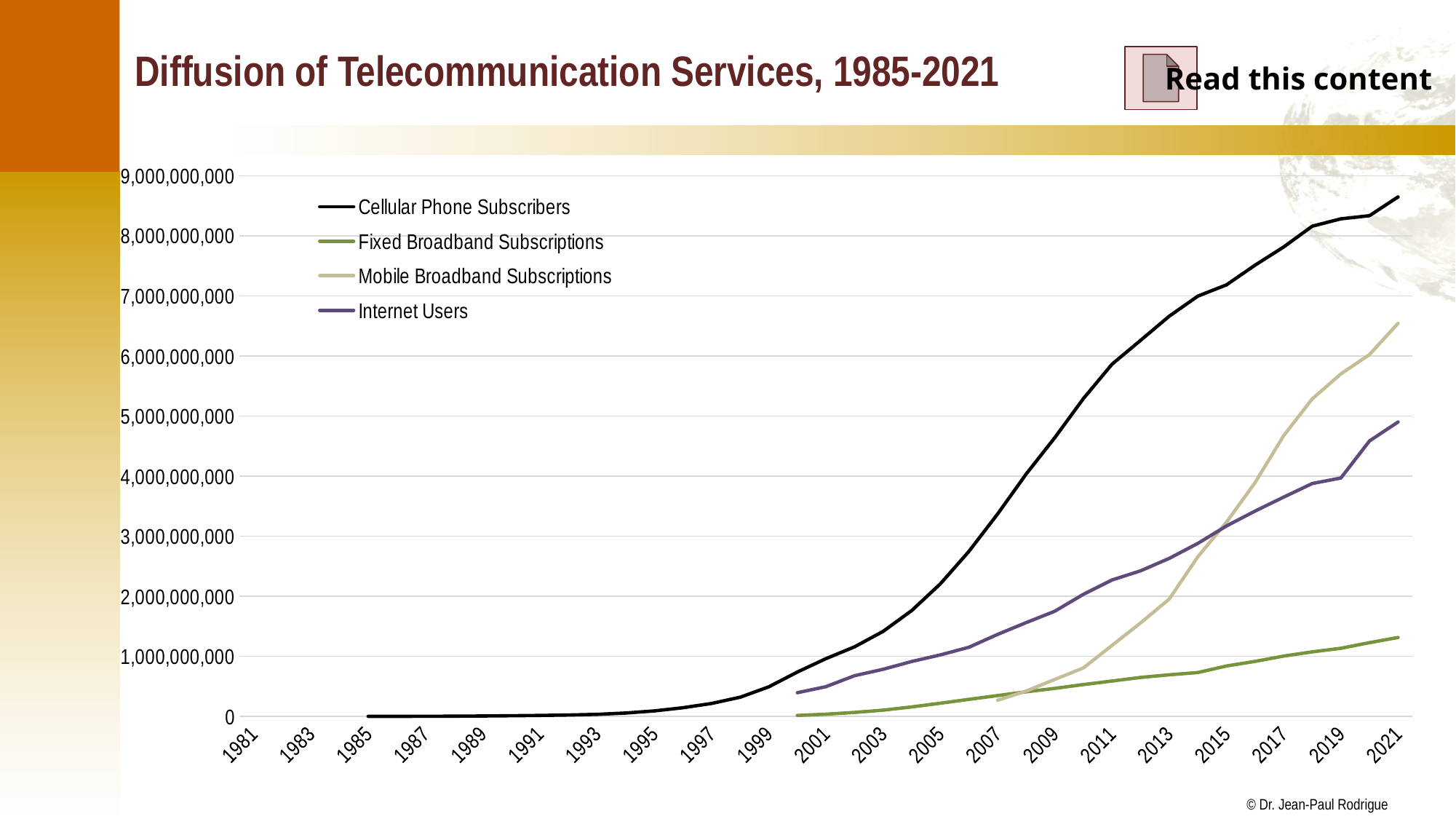
Is the value for Internet Users in 2013 greater or less than 3,000,000,000? less In 2011, which is larger: Internet Users or Mobile Broadband Subscriptions? Internet Users Which series is drawn with the black line? Cellular Phone Subscribers What kind of chart is shown on the slide? Line chart Which series has the highest value in 2021? Cellular Phone Subscribers Does the Cellular Phone Subscribers line rise or fall from 1985 to 2021? Rise Which series has the lowest value in 2021? Fixed Broadband Subscriptions How many series does the legend list? 4 What is the title of the chart? Diffusion of Telecommunication Services, 1985-2021 Is the value for Mobile Broadband Subscriptions in 2021 greater or less than 6,000,000,000? greater Is the value for Cellular Phone Subscribers in 2021 greater or less than 8,000,000,000? greater